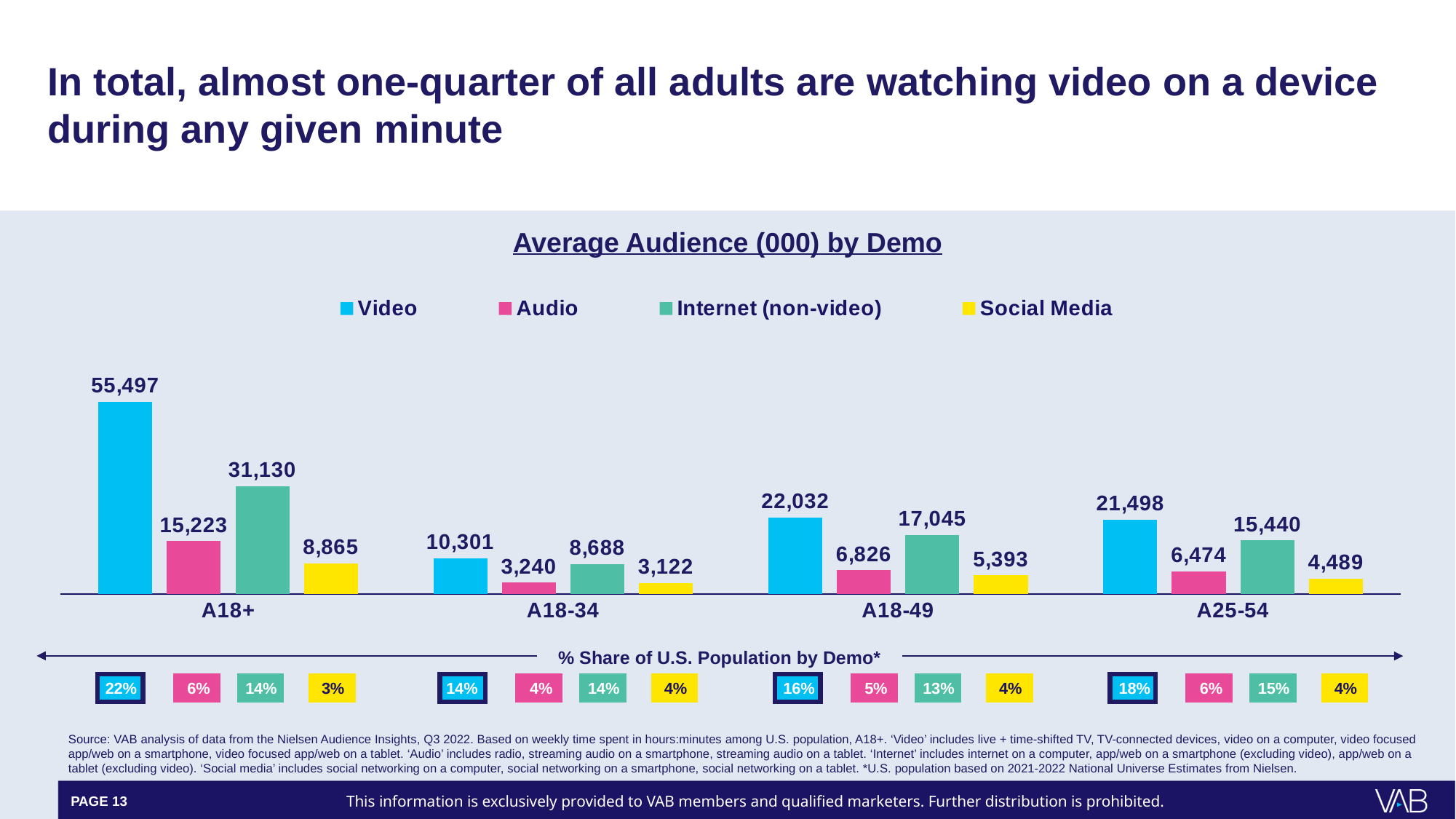
What is the Internet (non-video) value for A18-49? 17,045 How many series does the legend list? 4 What is the difference between the Internet (non-video) and Audio values for A18+? 15,907 What is the Video value for A18+? 55,497 Which has the larger Audio value, A18-49 or A25-54? A18-49 What is the Social Media value for A25-54? 4,489 How many demo categories are shown on the x axis? 4 Which demo has the highest Video value? A18+ Which demo has the lowest Social Media value? A18-34 What is the Audio value for A18-34? 3,240 What kind of chart is shown on the slide? Bar chart What is the difference between the Video values for A18-49 and A25-54? 534